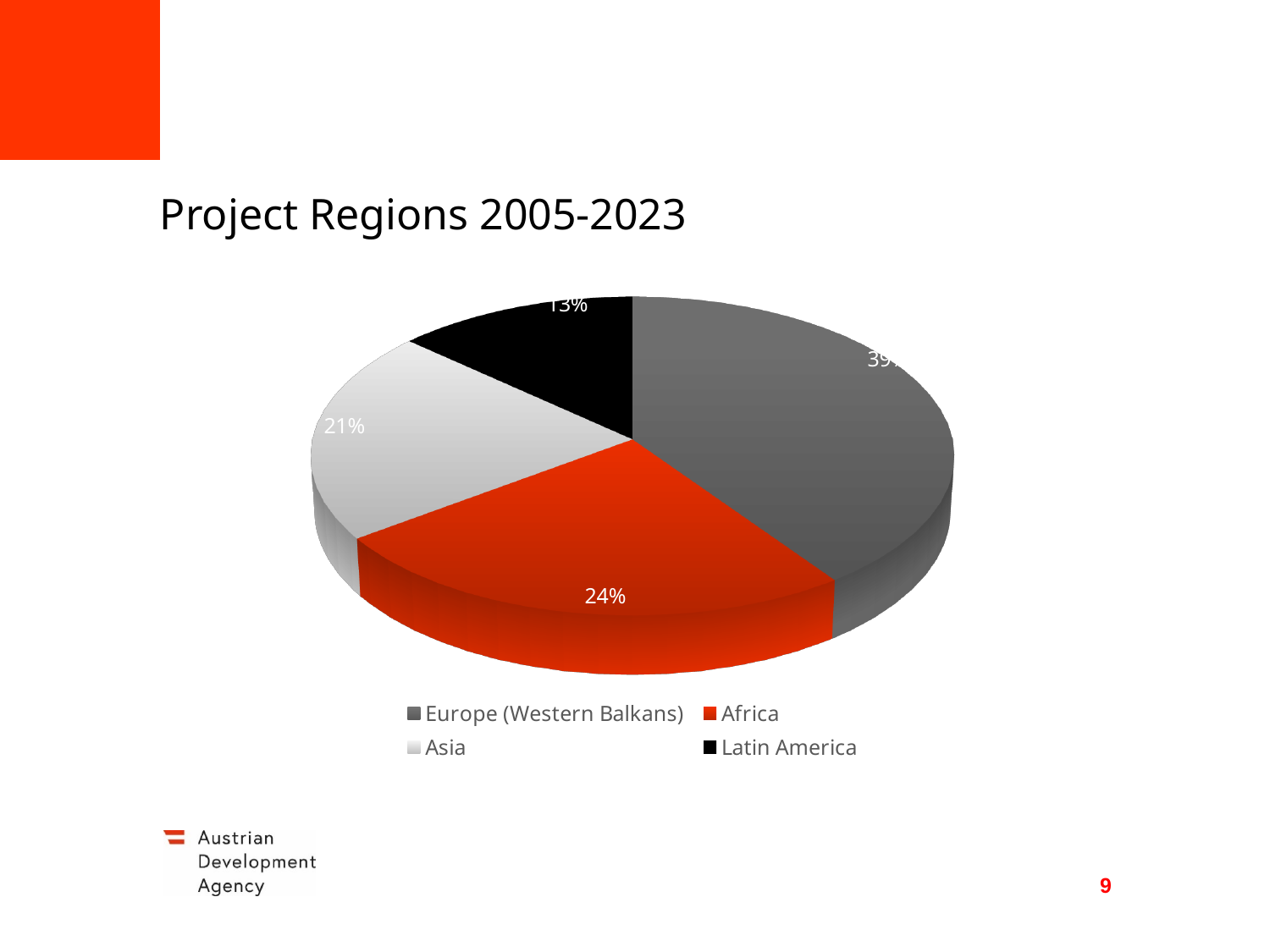
What is the title of the chart? Project Regions 2005-2023 Which is larger, the share for Africa or the share for Latin America? Africa What type of chart is shown on the slide? Pie chart What share of the pie does Asia account for? 21% What share of the pie does Latin America account for? 13% What share of the pie does Africa account for? 24% How many regions are shown in the pie chart? 4 What is the difference in percentage points between Africa's share and Asia's share? 3% Which region has the smallest slice of the pie? Latin America Which region has the largest slice of the pie? Europe (Western Balkans) What is the difference in percentage points between Asia's share and Latin America's share? 8% How many entries does the legend list? 4